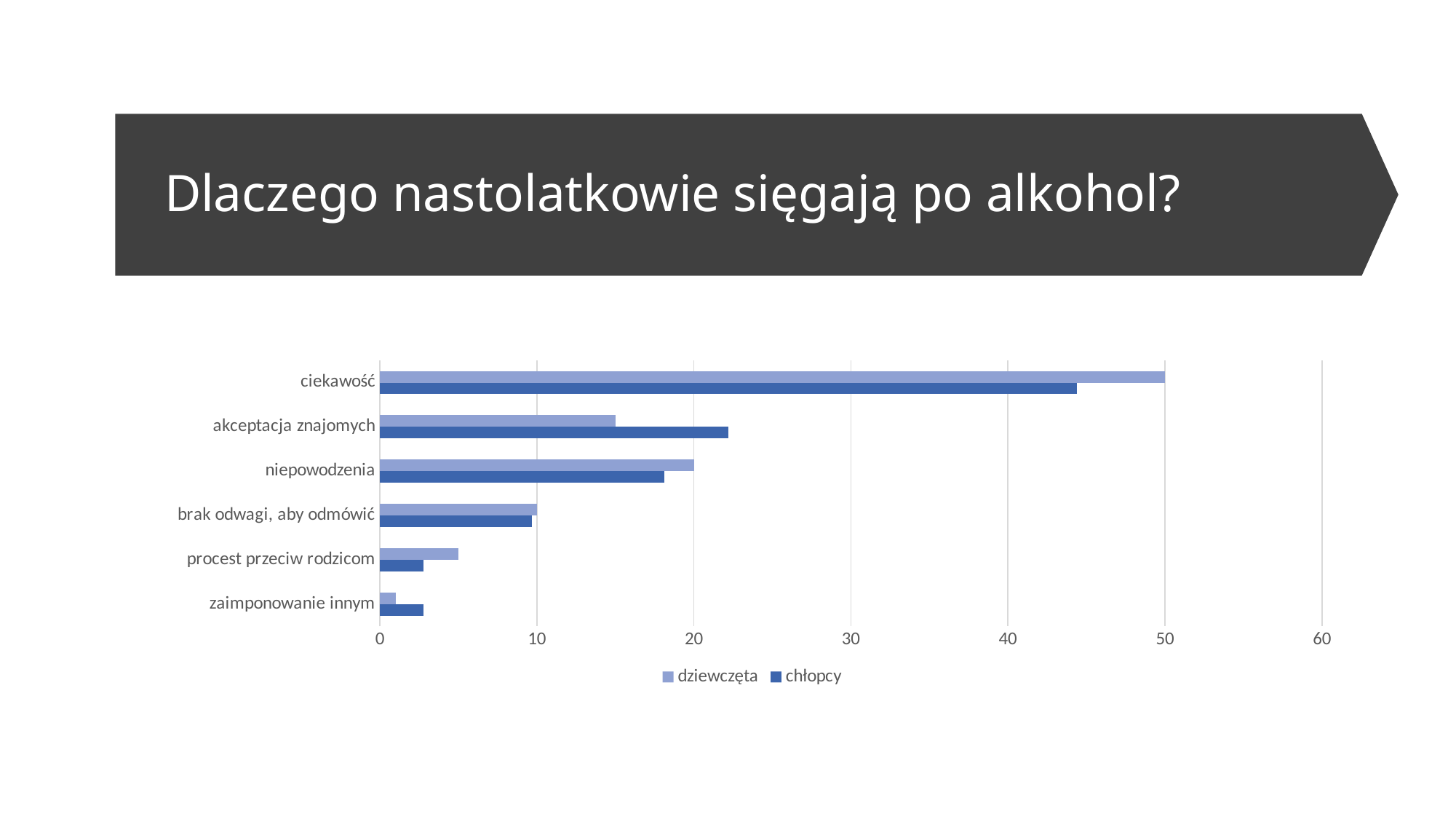
What kind of chart is shown on the slide? bar chart What is the value for dziewczęta in the ciekawość category? 50 What is the value for dziewczęta in the niepowodzenia category? 20 Which category has the highest value for dziewczęta? ciekawość How many series does the legend list? 2 In the akceptacja znajomych category, which series has the larger value, dziewczęta or chłopcy? chłopcy What are the two series named in the legend? dziewczęta and chłopcy Which category has the lowest value for dziewczęta? zaimponowanie innym Is the value for chłopcy in the akceptacja znajomych category greater or less than 20? greater Is the value for chłopcy in the ciekawość category greater or less than 40? greater How many categories are shown on the chart? 6 Which category has the highest value for chłopcy? ciekawość